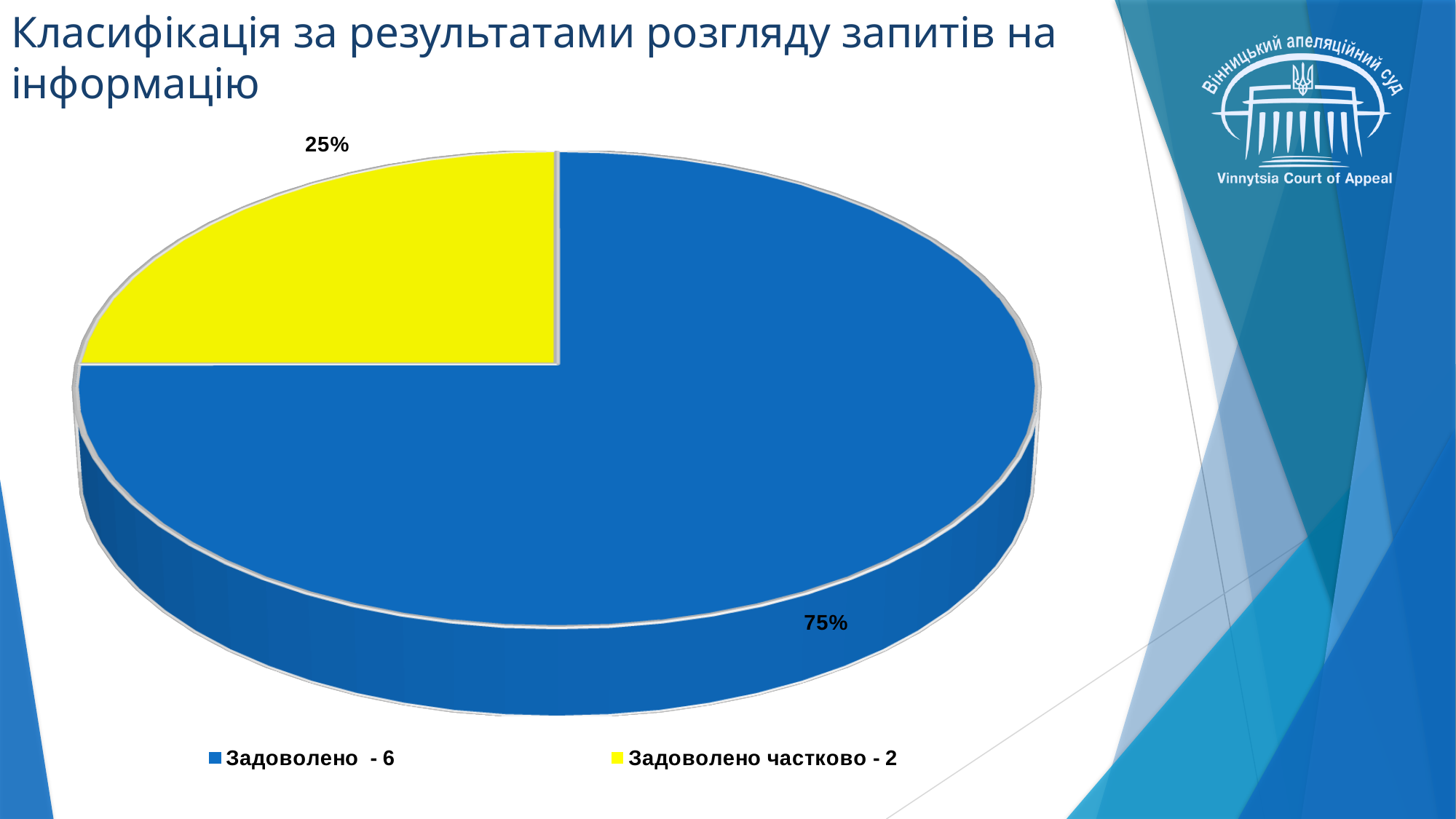
Which category has the largest slice of the pie? Задоволено - 6 How many slices does the pie chart have? 2 How many entries does the legend list? 2 What is the title of the slide containing the chart? Класифікація за результатами розгляду запитів на інформацію What colour is the 'Задоволено частково - 2' slice? yellow What kind of chart is shown on the slide? pie chart What is the difference in percentage points between the 'Задоволено - 6' slice and the 'Задоволено частково - 2' slice? 50% Which slice is larger: 'Задоволено - 6' or 'Задоволено частково - 2'? Задоволено - 6 Which category has the smallest slice of the pie? Задоволено частково - 2 What percentage share does the 'Задоволено - 6' slice have? 75% What percentage share does the 'Задоволено частково - 2' slice have? 25%